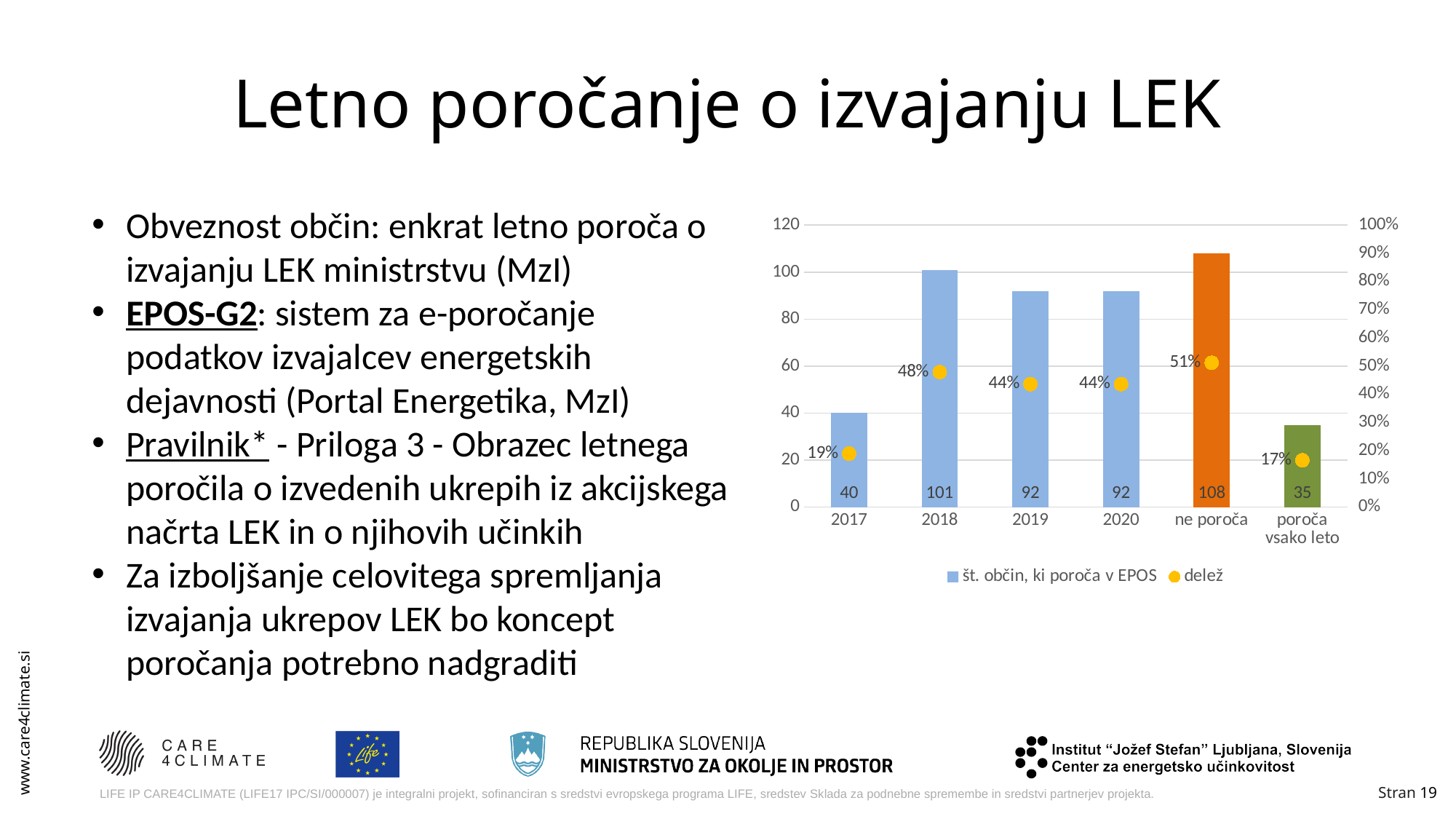
What share (delež) is shown for 2017? 19% How many series does the chart legend list? 2 What is the value of the bar for 'ne poroča'? 108 What kind of chart is shown on the slide? Bar chart with a line/marker series What is the difference between the bar values for 2018 and 2017? 61 What is the name of the first series in the chart legend? št. občin, ki poroča v EPOS Which category has the highest bar value? ne poroča How many municipalities reported in EPOS in 2018 according to the chart? 101 Which category has the lowest bar value? poroča vsako leto Which is larger, the bar value for 2019 or for 2017? 2019 How many categories are shown on the x axis of the chart? 6 What share (delež) is shown for 'poroča vsako leto'? 17%